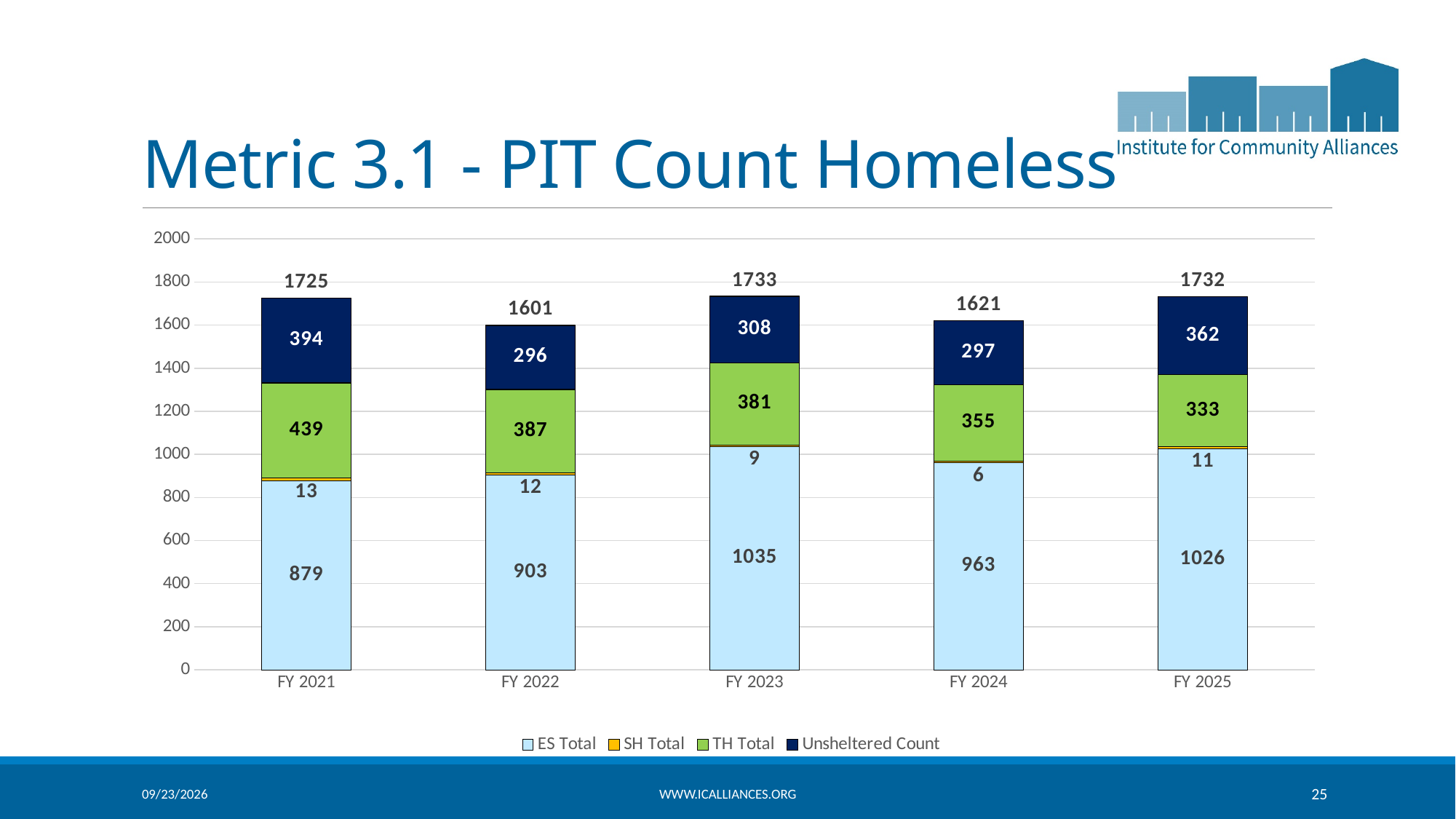
What is the difference between the ES Total for FY 2023 and FY 2021? 156 What is the SH Total value for FY 2024? 6 What is the Unsheltered Count for FY 2021? 394 What is the total of the stacked bar for FY 2025? 1732 How many fiscal years are shown on the x axis? 5 Which fiscal year has the lowest stacked bar total? FY 2022 What is the ES Total value for FY 2023? 1035 How many series does the legend list? 4 Which fiscal year has the highest TH Total value? FY 2021 What is the TH Total value for FY 2022? 387 What kind of chart is shown on the slide? Stacked bar chart Is the Unsheltered Count larger in FY 2021 or FY 2025? FY 2021